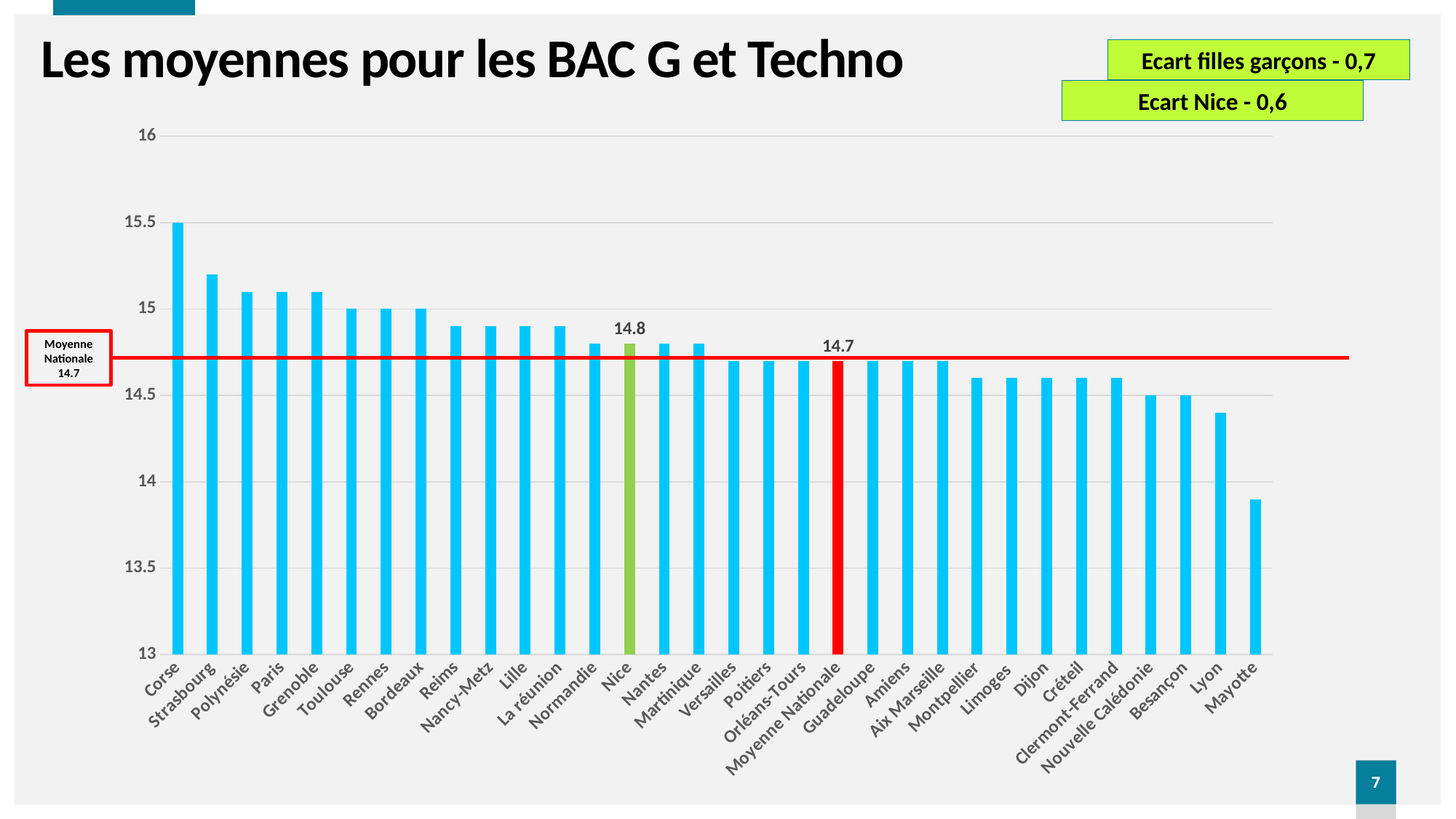
Which is larger, the value for Corse or the value for Strasbourg? Corse Is the value for Mayotte greater or less than 14? less Do the values rise or fall from left to right along the x axis? fall Which category has the highest bar? Corse What kind of chart is shown on the slide? bar chart Which category has the lowest bar? Mayotte What is the value shown for Nice? 14.8 Is the value for Lyon greater or less than 14.5? less What is the difference between the value for Nice and the value for Moyenne Nationale? 0.1 What is the value shown for Moyenne Nationale? 14.7 Is the value for Corse greater or less than 15? greater How many categories are shown on the x axis? 32